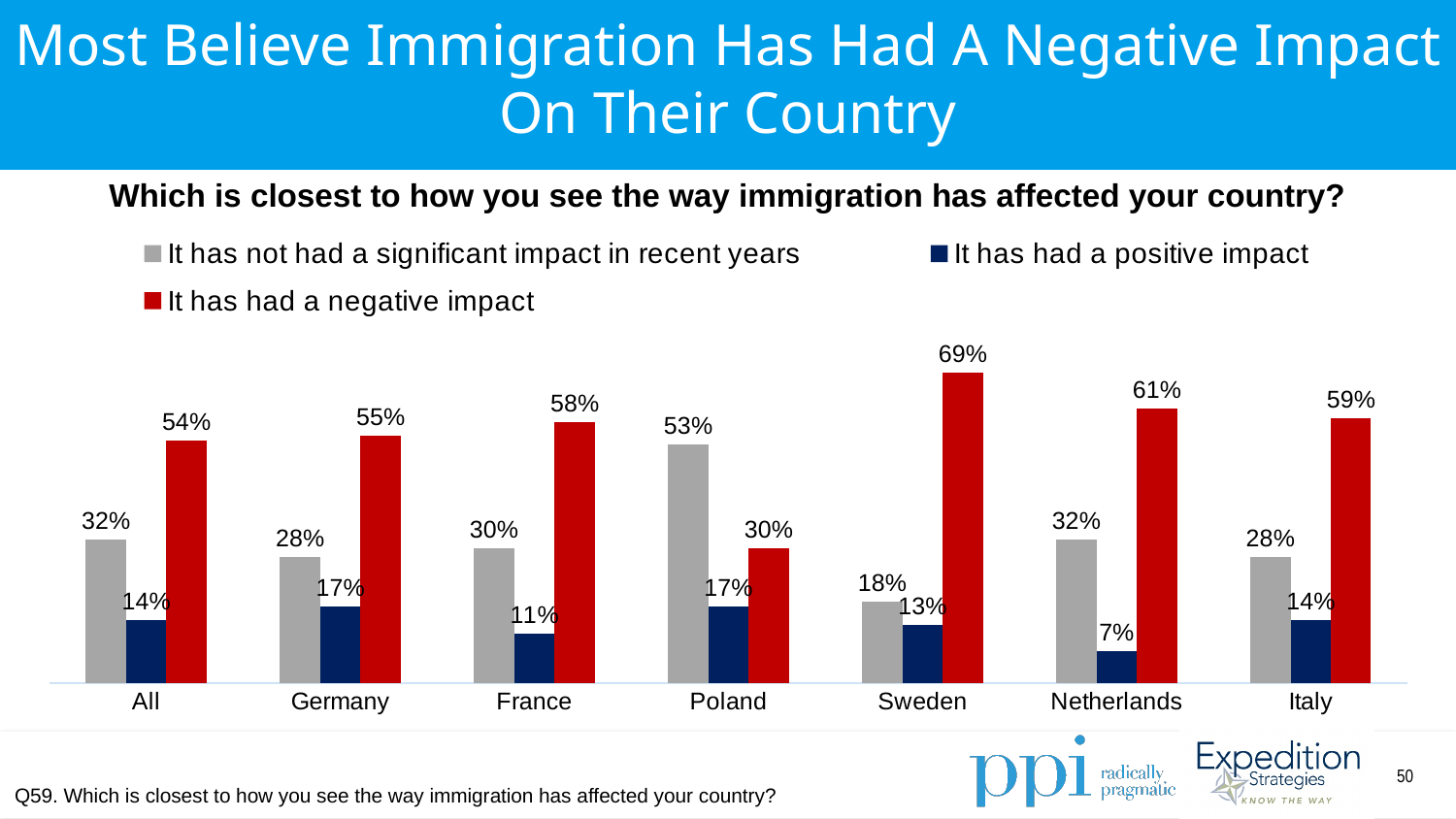
Which colour represents 'It has had a negative impact' in the legend? Red Which is larger: the share in France saying immigration has had a negative impact, or the share in Germany? France How many series does the legend list? 3 What percentage of respondents in Sweden say immigration has had a negative impact? 69% Which country has the highest share saying immigration has had a negative impact? Sweden What percentage of respondents in the Netherlands say immigration has had a positive impact? 7% What is the difference between the negative impact share in Sweden and in Poland? 39 percentage points Which country has the lowest share saying immigration has had a positive impact? Netherlands What percentage of respondents in Poland say immigration has not had a significant impact in recent years? 53% What type of chart is shown on the slide? Bar chart What is the total of the three response shares for Italy? 101% How many countries or groups are shown on the x axis? 7